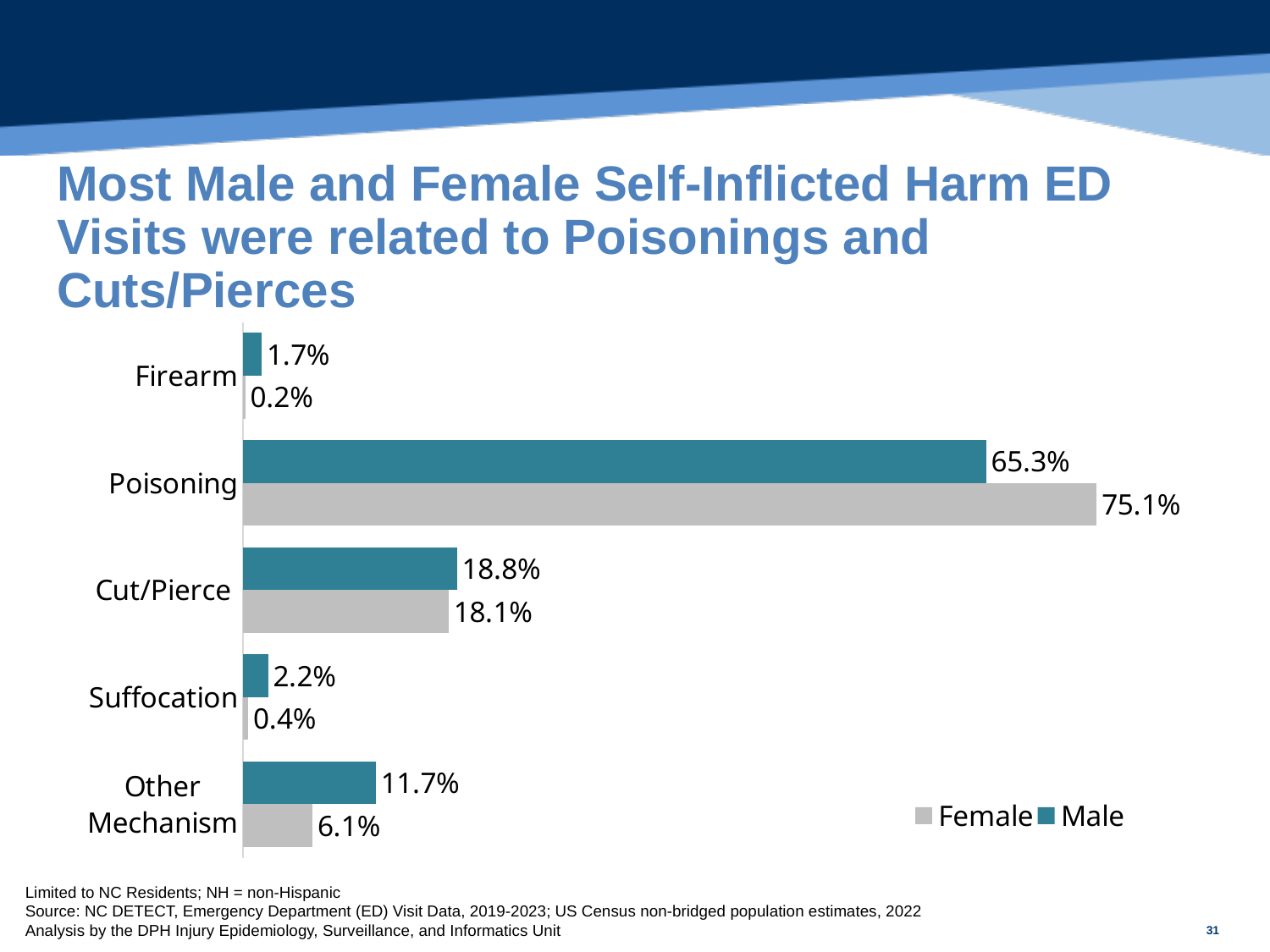
What kind of chart is shown on the slide? Bar chart What is the Male value for Poisoning? 65.3% How many categories are shown on the chart? 5 How many series does the legend list? 2 What is the difference between the Female and Male values for Poisoning? 9.8% Which category has the highest Male value? Poisoning Which category has the lowest Female value? Firearm What is the Female value for Other Mechanism? 6.1% What is the Female value for Poisoning? 75.1% Which is larger for Other Mechanism, the Male value or the Female value? Male What is the Male value for Cut/Pierce? 18.8% What is the Female value for Firearm? 0.2%